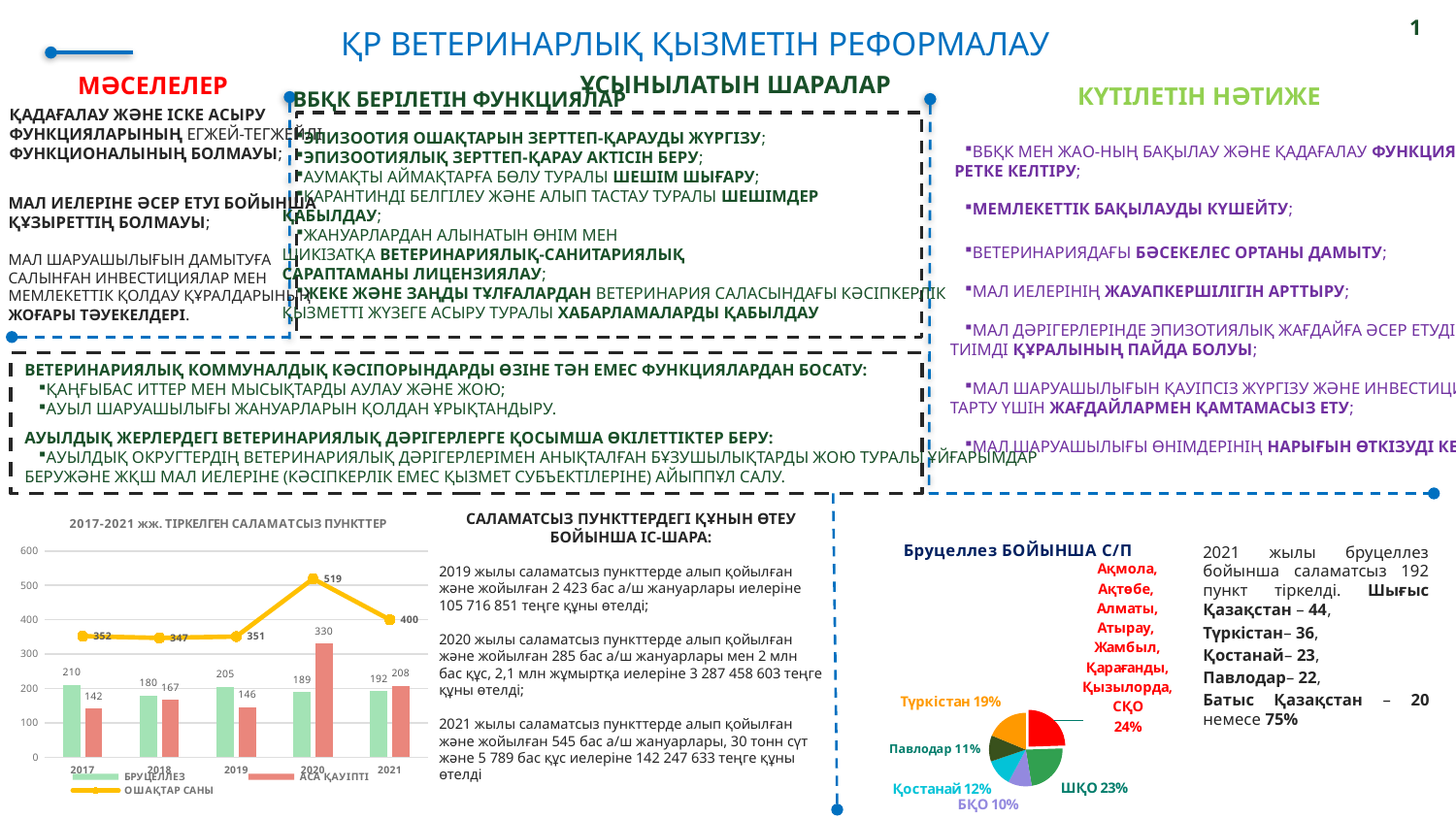
In the chart "2017-2021 жж. ТІРКЕЛГЕН САЛАМАТСЫЗ ПУНКТТЕР", in which year is ОШАҚТАР САНЫ highest? 2020 In the chart "2017-2021 жж. ТІРКЕЛГЕН САЛАМАТСЫЗ ПУНКТТЕР", what is the БРУЦЕЛЛЕЗ value for 2017? 210 How many years are shown on the x axis of the chart "2017-2021 жж. ТІРКЕЛГЕН САЛАМАТСЫЗ ПУНКТТЕР"? 5 In the chart "2017-2021 жж. ТІРКЕЛГЕН САЛАМАТСЫЗ ПУНКТТЕР", in which year is ОШАҚТАР САНЫ lowest? 2018 In the chart "2017-2021 жж. ТІРКЕЛГЕН САЛАМАТСЫЗ ПУНКТТЕР", which is larger in 2021: БРУЦЕЛЛЕЗ or АСА ҚАУІПТІ? АСА ҚАУІПТІ How many series does the legend of the chart "2017-2021 жж. ТІРКЕЛГЕН САЛАМАТСЫЗ ПУНКТТЕР" list? 3 In the pie chart "Бруцеллез БОЙЫНША С/П", what share does ШҚО have? 23% In the chart "2017-2021 жж. ТІРКЕЛГЕН САЛАМАТСЫЗ ПУНКТТЕР", what is the difference between the АСА ҚАУІПТІ and БРУЦЕЛЛЕЗ values in 2020? 141 In the pie chart "Бруцеллез БОЙЫНША С/П", which has the larger share: Қостанай or Павлодар? Қостанай In the chart "2017-2021 жж. ТІРКЕЛГЕН САЛАМАТСЫЗ ПУНКТТЕР", what is the АСА ҚАУІПТІ value for 2020? 330 In the chart "2017-2021 жж. ТІРКЕЛГЕН САЛАМАТСЫЗ ПУНКТТЕР", what is the ОШАҚТАР САНЫ value for 2020? 519 What kind of chart is the bottom-right chart titled "Бруцеллез БОЙЫНША С/П"? pie chart